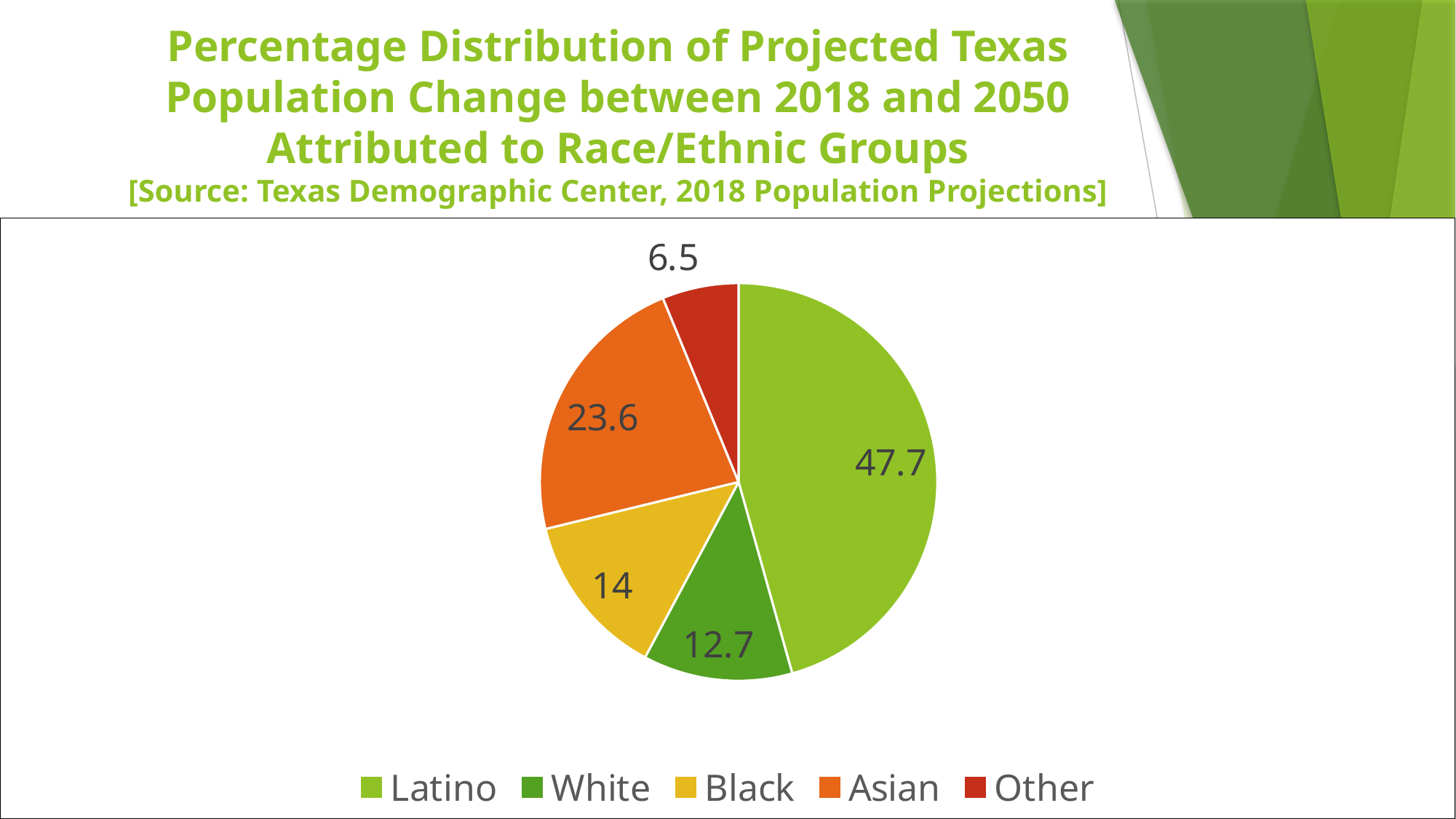
What is the value for Other? 6.5 What is the difference between the Latino and Asian values? 24.1 Which is larger, the value for Black or the value for White? Black Which colour represents Asian in the legend? Orange What is the value for White? 12.7 Which group has the smallest slice? Other What is the value for Asian? 23.6 What is the value for Latino? 47.7 What is the value for Black? 14 How many groups are shown in the pie chart? 5 Which group has the largest slice? Latino What kind of chart is shown on the slide? Pie chart